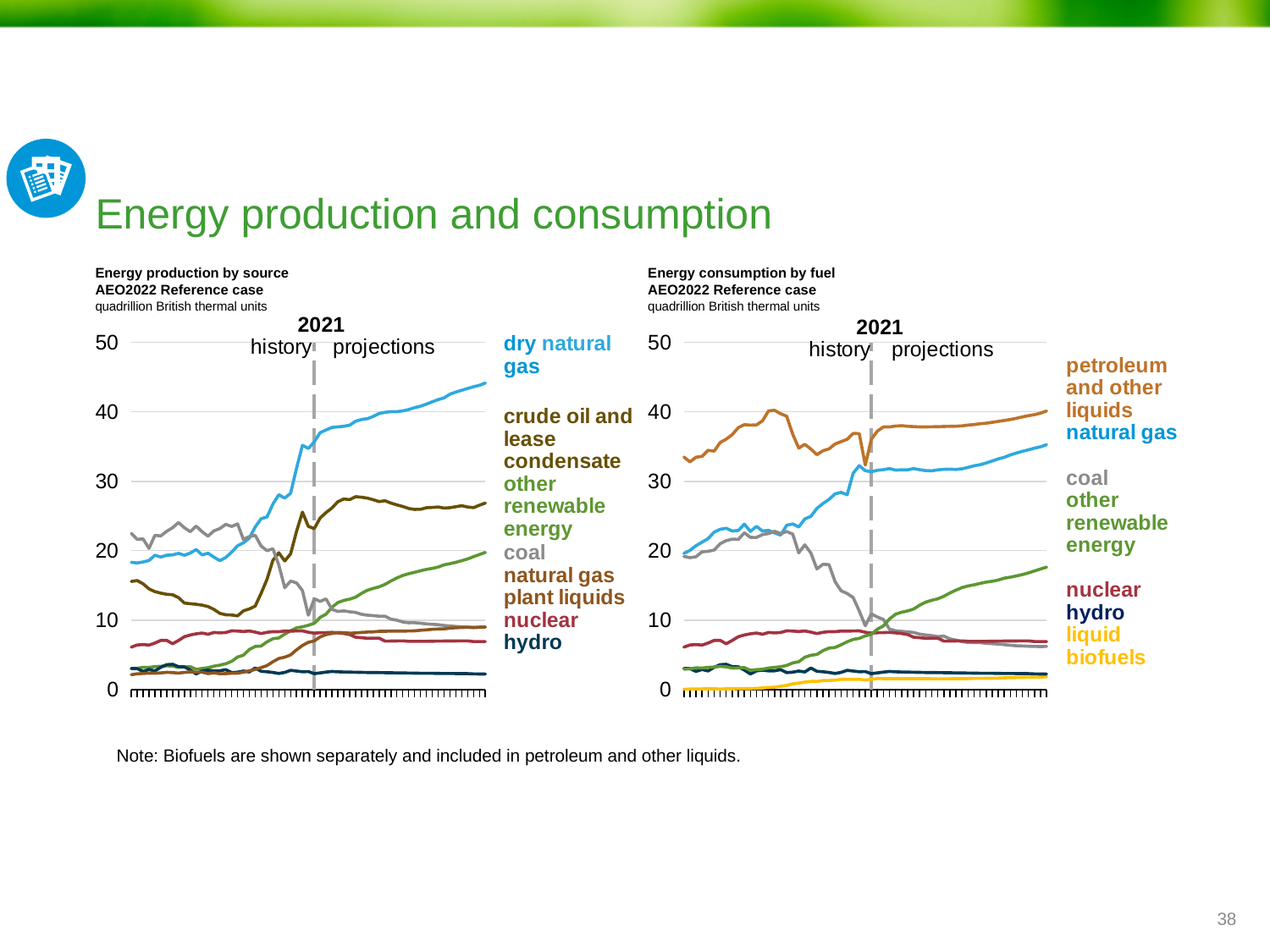
What unit is used on the y axis of both charts? quadrillion British thermal units In the 'Energy production by source' chart, does the coal line rise or fall over the projection period? fall In the 'Energy consumption by fuel' chart, is the value for coal at the end of the projections greater or less than 10? less How many series are labelled on the 'Energy production by source' chart? 7 How many series are labelled on the 'Energy consumption by fuel' chart? 7 In the 'Energy consumption by fuel' chart, does the other renewable energy line rise or fall over the projection period? rise What kind of chart is the 'Energy production by source' chart? line chart In the 'Energy production by source' chart, is the value for crude oil and lease condensate at the end of the projections greater or less than 30? less In the 'Energy consumption by fuel' chart, which fuel has the highest value at the end of the projection period? petroleum and other liquids In the 'Energy consumption by fuel' chart, is the value for natural gas at the end of the projections greater or less than 30? greater In the 'Energy production by source' chart, which source has the highest value at the end of the projection period? dry natural gas